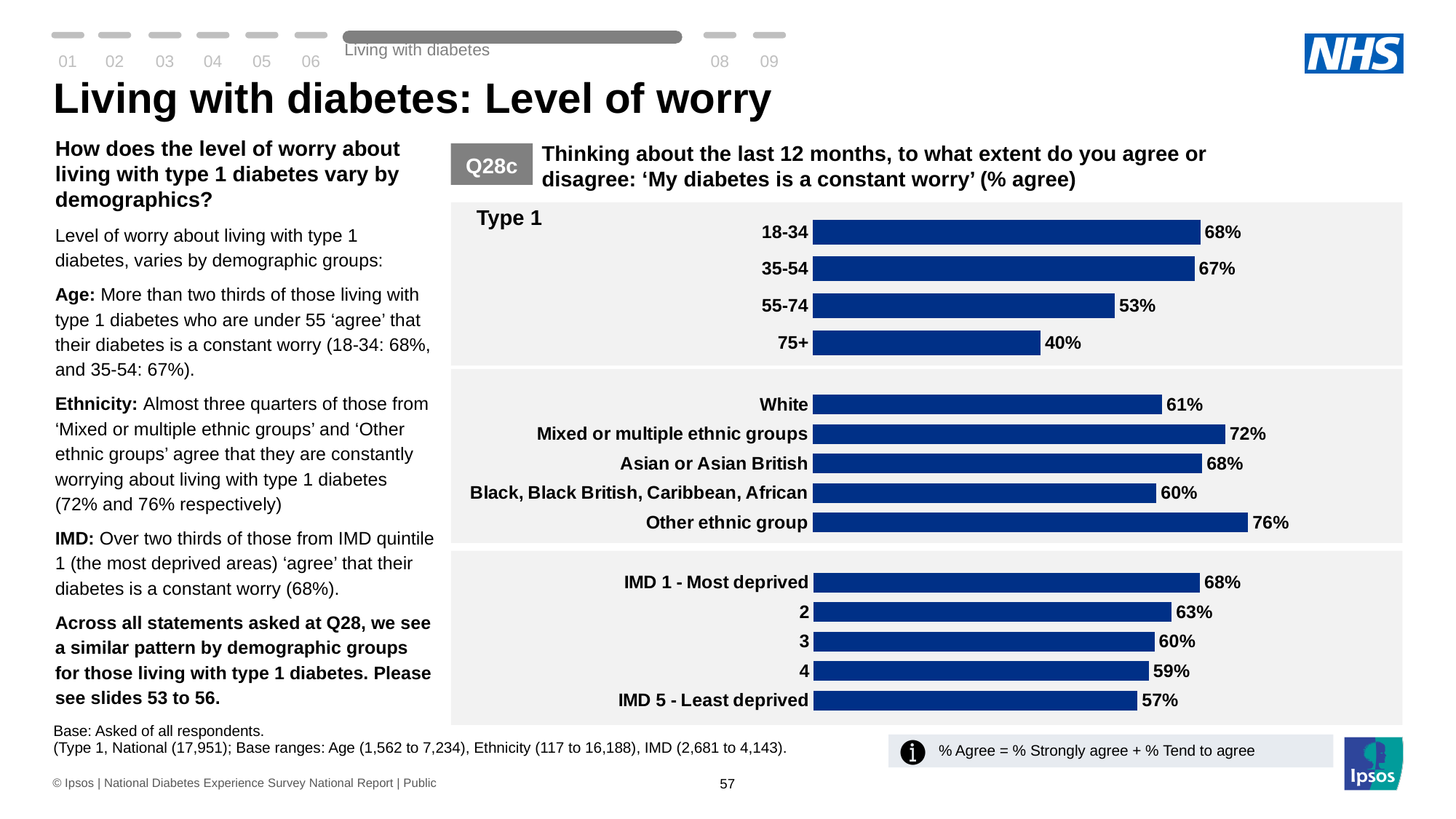
What type of chart is shown on the slide? Bar chart What percentage of those aged 75+ agree that their diabetes is a constant worry? 40% What is the value shown for 'Mixed or multiple ethnic groups'? 72% Which age group has the lowest percentage agreeing? 75+ What percentage is shown for 'IMD 5 - Least deprived'? 57% How many categories in total are plotted on the chart? 14 How many age groups are shown on the chart? 4 Which has a higher value: 'White' or 'Asian or Asian British'? Asian or Asian British Do the values rise or fall as you move from IMD 1 - Most deprived to IMD 5 - Least deprived? Fall What is the difference between 'IMD 1 - Most deprived' and 'IMD 5 - Least deprived'? 11 What is the difference in percentage points between the 18-34 and 75+ age groups? 28 Which category on the chart has the highest percentage agreeing? Other ethnic group